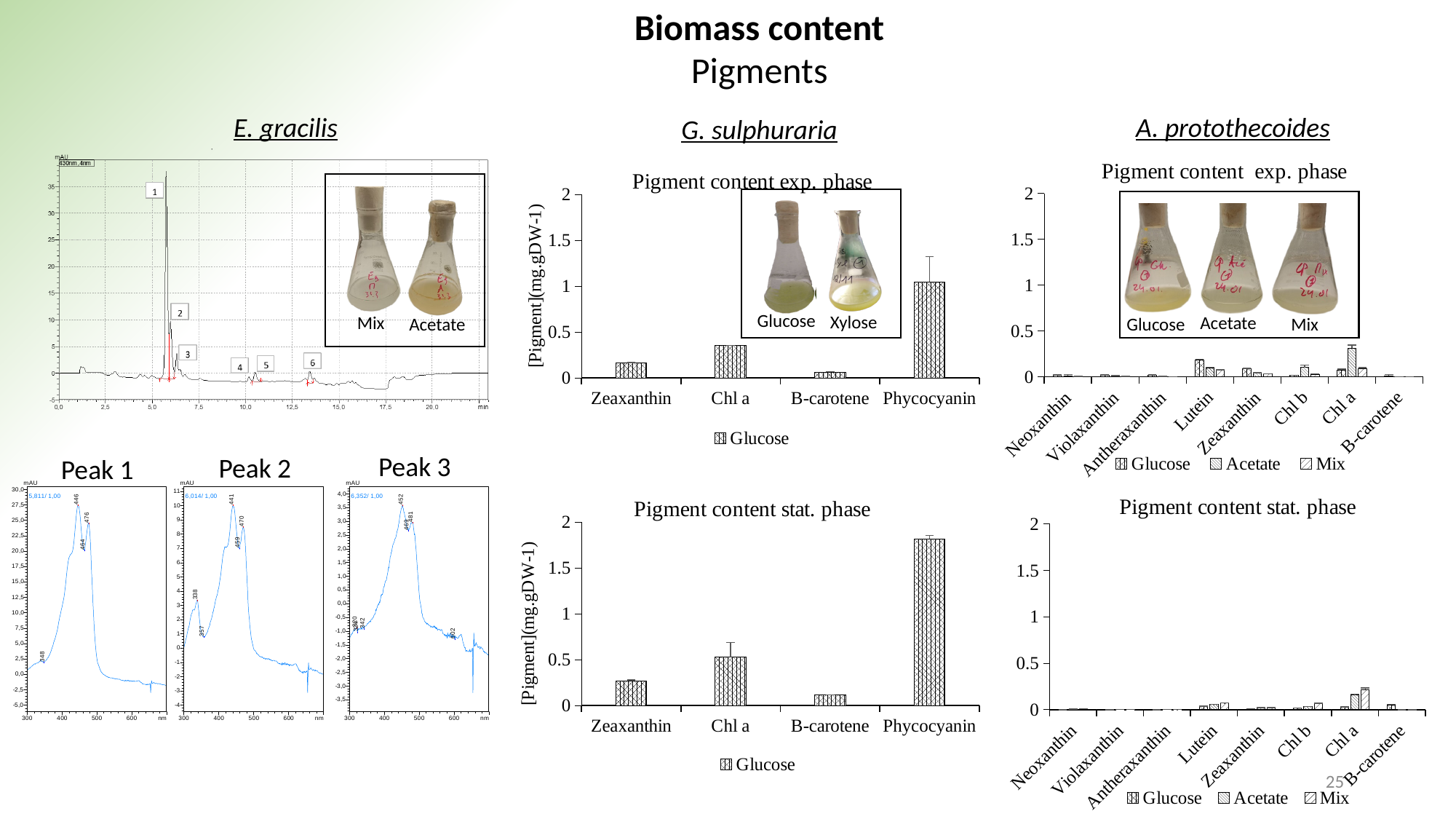
How many pigment categories are shown on the x axis of the A. protothecoides 'Pigment content exp. phase' chart? 8 In the G. sulphuraria 'Pigment content stat. phase' chart, which is larger, Zeaxanthin or Chl a? Chl a In the G. sulphuraria 'Pigment content stat. phase' chart, is the value for Phycocyanin greater or less than 1.5? greater In the A. protothecoides 'Pigment content exp. phase' chart, which series has the highest value for Chl a? Acetate In the G. sulphuraria 'Pigment content exp. phase' chart, which pigment has the highest value? Phycocyanin What kind of chart is the G. sulphuraria 'Pigment content exp. phase' chart? bar chart In the G. sulphuraria 'Pigment content exp. phase' chart, which pigment has the lowest value? B-carotene What is the y-axis label of the G. sulphuraria 'Pigment content stat. phase' chart? [Pigment](mg.gDW-1) How many pigment categories are shown on the x axis of the G. sulphuraria 'Pigment content stat. phase' chart? 4 How many series does the legend list for the A. protothecoides 'Pigment content exp. phase' chart? 3 In the G. sulphuraria 'Pigment content stat. phase' chart, is the value for Chl a greater or less than 1? less